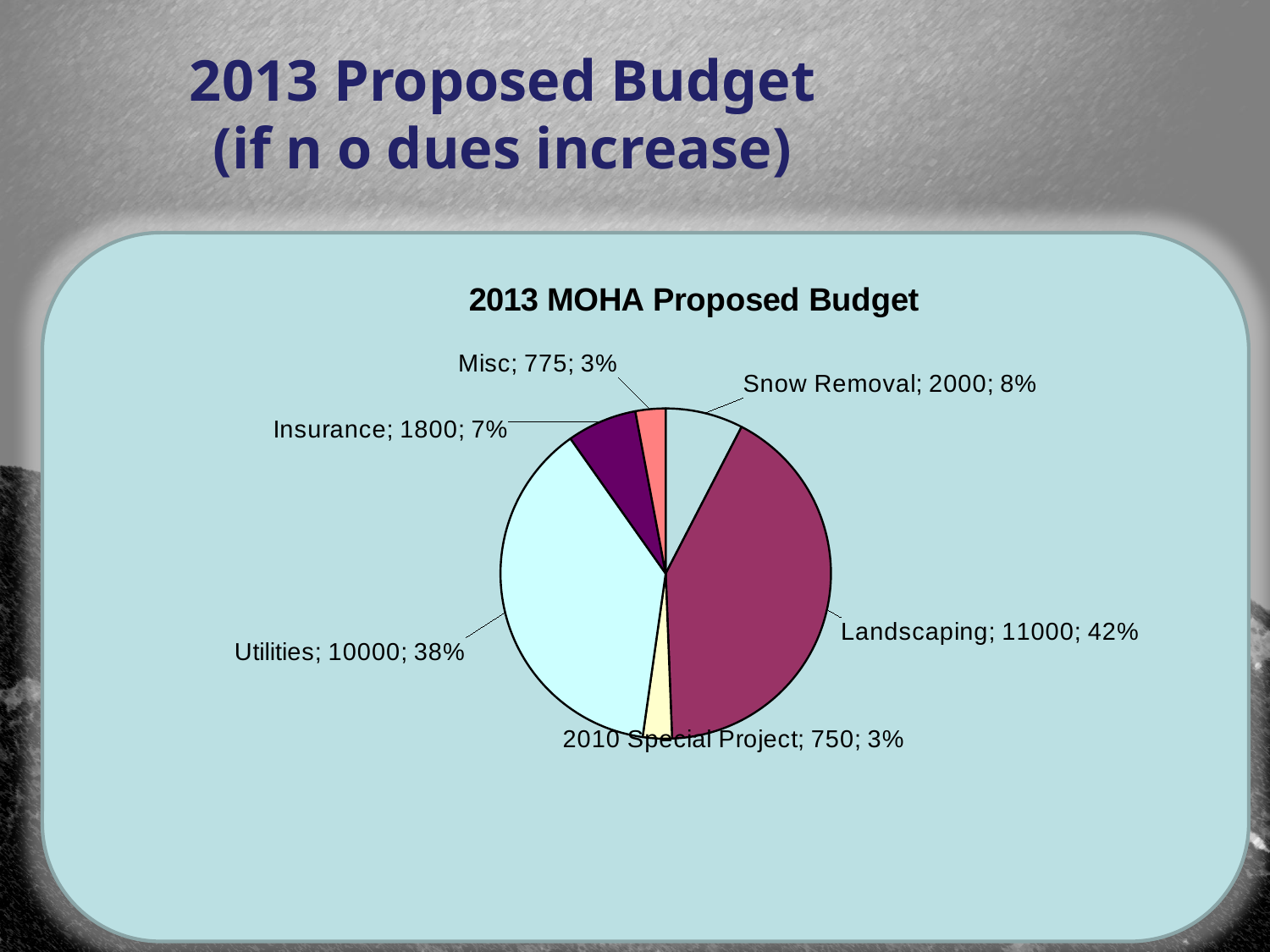
What share of the pie does Utilities represent? 38% What is the value for Insurance? 1800 What is the value for Snow Removal? 2000 What share of the pie does Snow Removal represent? 8% What kind of chart is shown on the slide? pie chart What is the value for Utilities? 10000 What is the difference between the values for Landscaping and Utilities? 1000 What is the value for Landscaping? 11000 How many slices does the pie chart have? 6 What is the title of the chart? 2013 MOHA Proposed Budget Which category has the largest slice of the pie? Landscaping Which is larger, the value for Misc or the value for 2010 Special Project? Misc